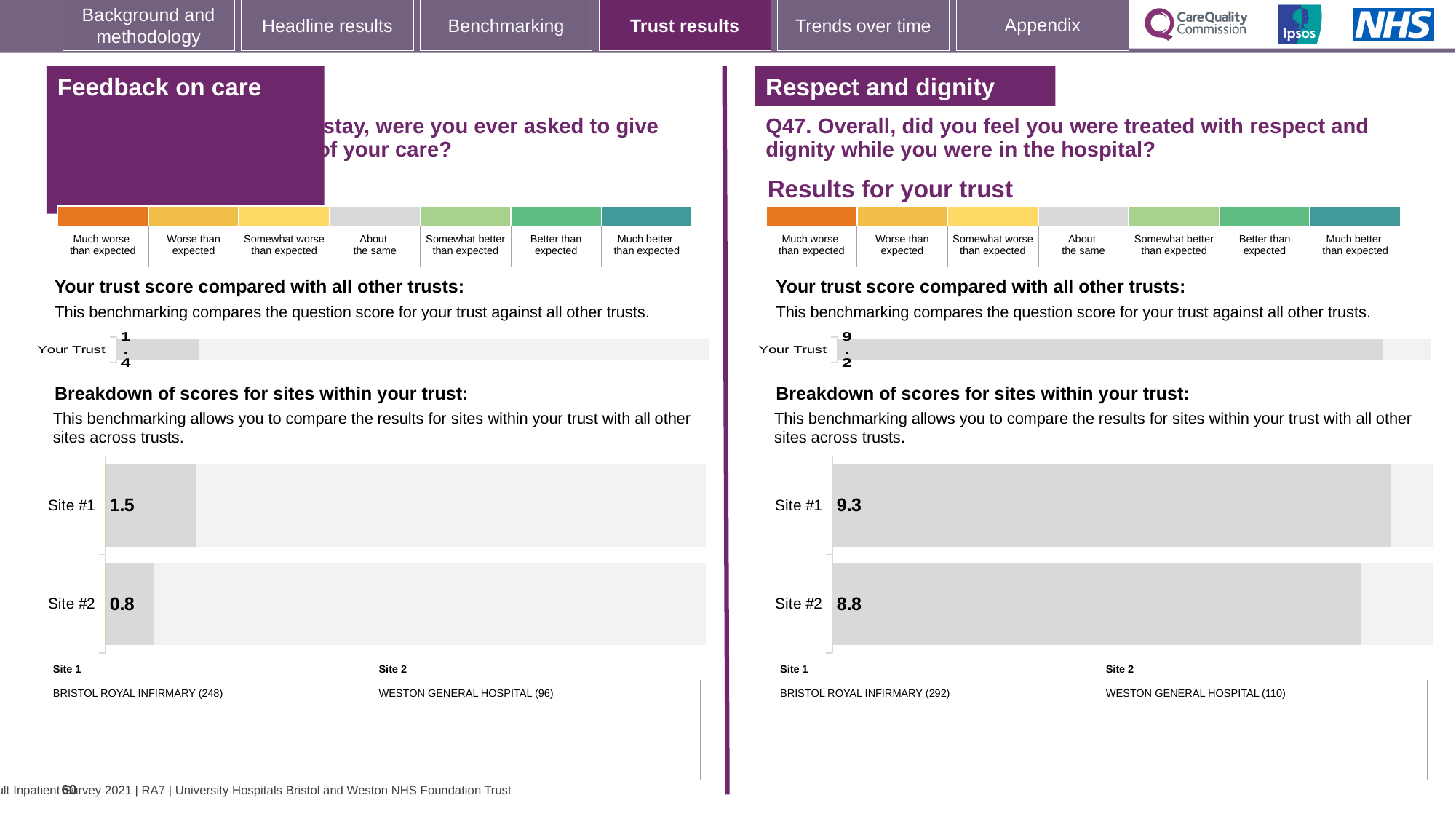
In the 'Feedback on care' breakdown of scores for sites chart, what is the difference between the Site #1 and Site #2 scores? 0.7 In the 'Feedback on care' breakdown of scores for sites chart, which site has the higher score? Site #1 In the 'Feedback on care' section, what is the score shown for Site #1 in the breakdown of scores for sites chart? 1.5 In the 'Respect and dignity' section, what is the score shown for Site #1 in the breakdown of scores for sites chart? 9.3 In the 'Feedback on care' section, what score is shown for 'Your Trust' in the trust score chart? 1.4 In the 'Respect and dignity' section, what is the score shown for Site #2 in the breakdown of scores for sites chart? 8.8 In the 'Respect and dignity' breakdown of scores for sites chart, which site has the lower score? Site #2 What type of chart is used for the breakdown of scores for sites in the 'Feedback on care' section? Bar chart In the 'Respect and dignity' section, what score is shown for 'Your Trust' in the trust score chart? 9.2 In the 'Feedback on care' section, what is the score shown for Site #2 in the breakdown of scores for sites chart? 0.8 How many sites are shown in the 'Respect and dignity' breakdown of scores for sites chart? 2 In the 'Respect and dignity' breakdown of scores for sites chart, what is the difference between the Site #1 and Site #2 scores? 0.5